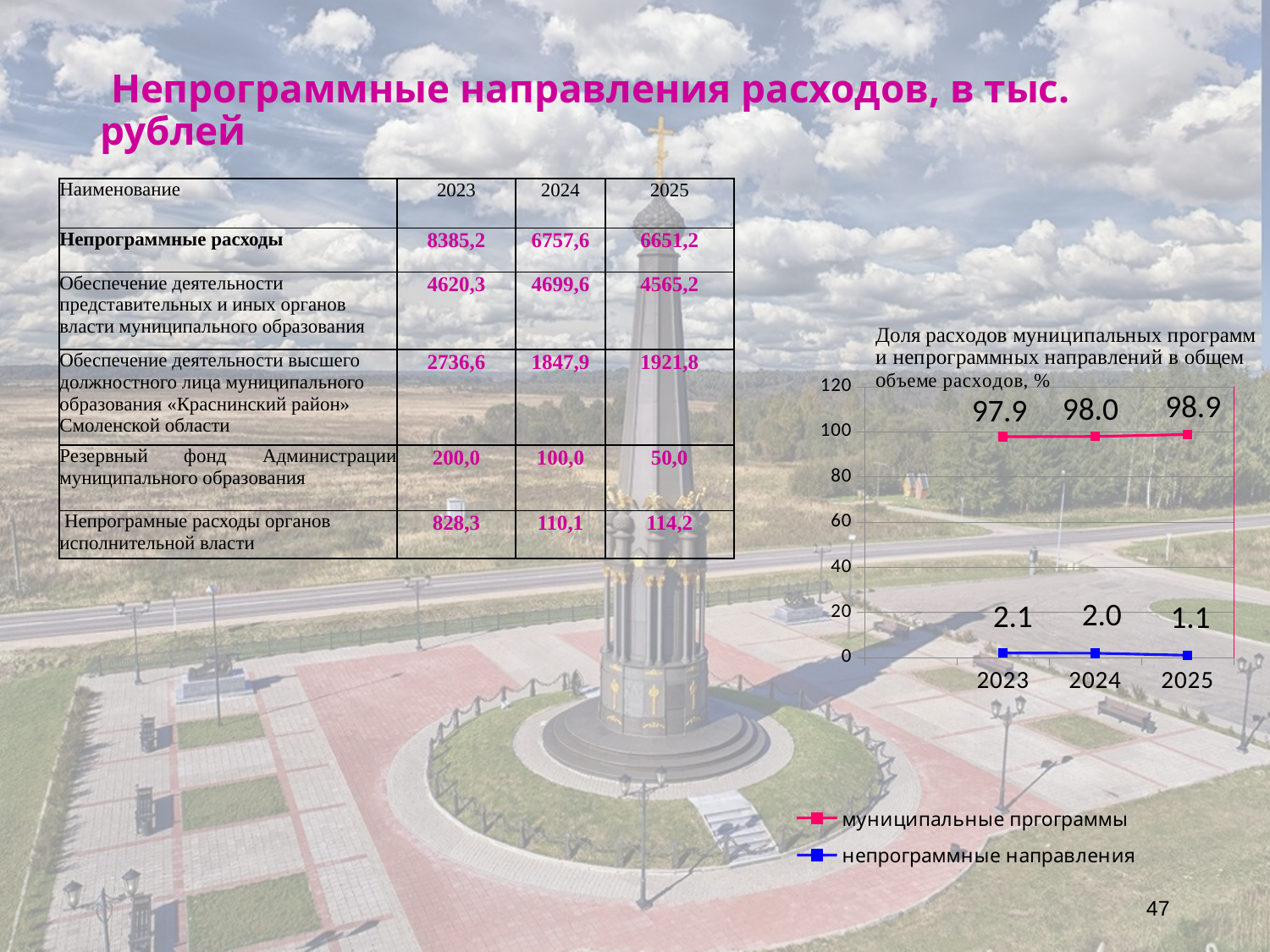
How many years are shown on the x axis? 3 What is the value for непрограммные направления in 2024? 2.0 How many series does the legend list? 2 What is the value for непрограммные направления in 2025? 1.1 What type of chart is shown on the slide? line chart What is the value for муниципальные программы in 2023? 97.9 In which year is the value for непрограммные направления lowest? 2025 Does the value for непрограммные направления rise or fall from 2023 to 2025? fall Which is larger in 2024: муниципальные программы or непрограммные направления? муниципальные программы What is the value for муниципальные программы in 2025? 98.9 What is the difference between the муниципальные программы values in 2025 and 2023? 1.0 In which year is the value for муниципальные программы highest? 2025